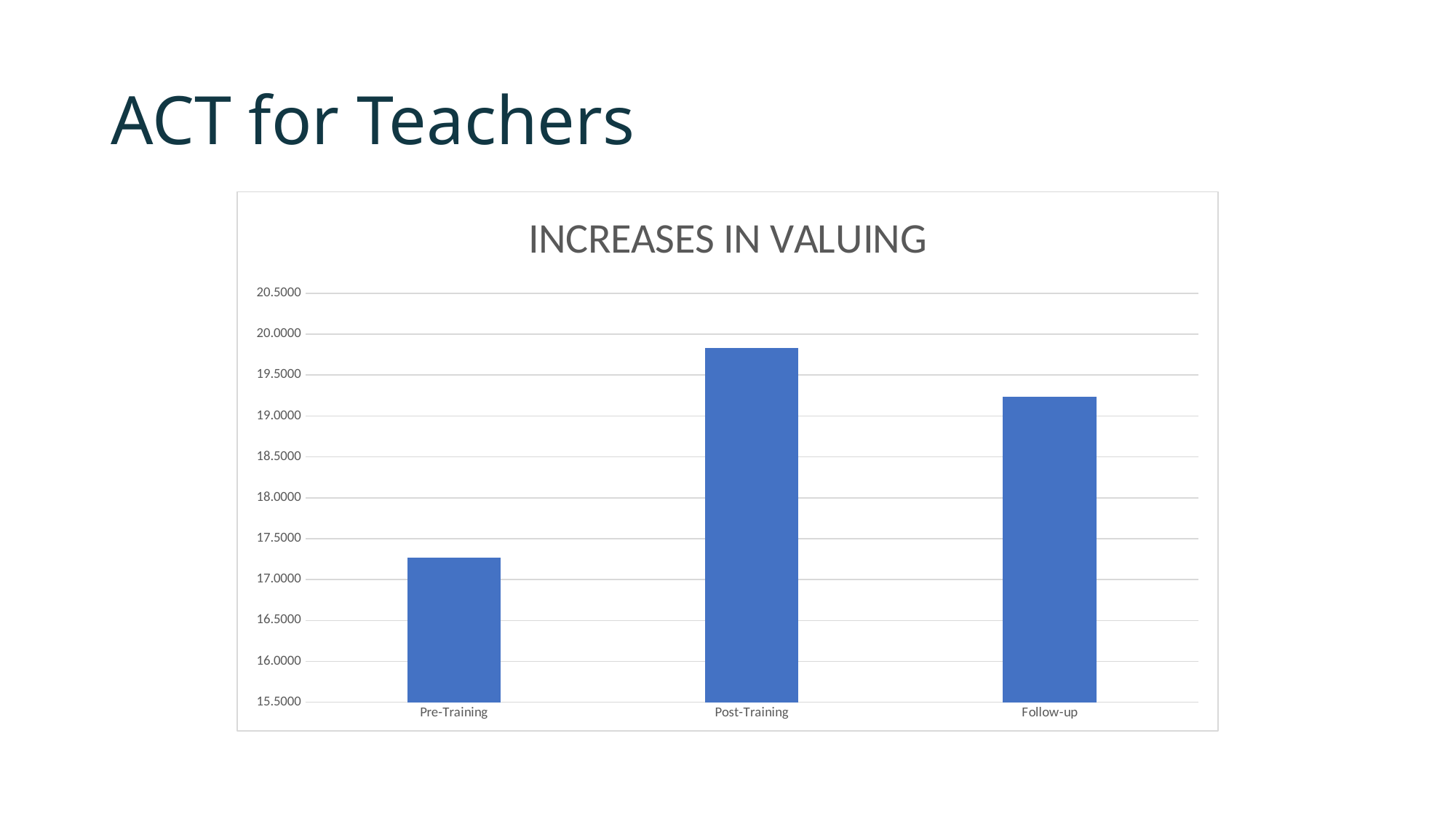
Which category has the lowest value? Pre-Training Is the value for Follow-up greater or less than 19.0000? greater What is the title of the chart? INCREASES IN VALUING Which category has the highest value? Post-Training Which is larger, the value for Post-Training or the value for Follow-up? Post-Training Is the value for Pre-Training greater or less than 17.5000? less Does the value rise or fall from Post-Training to Follow-up? fall Does the value rise or fall from Pre-Training to Post-Training? rise How many categories are plotted on the x axis? 3 Is the value for Post-Training greater or less than 20.0000? less What kind of chart is shown on the slide? bar chart